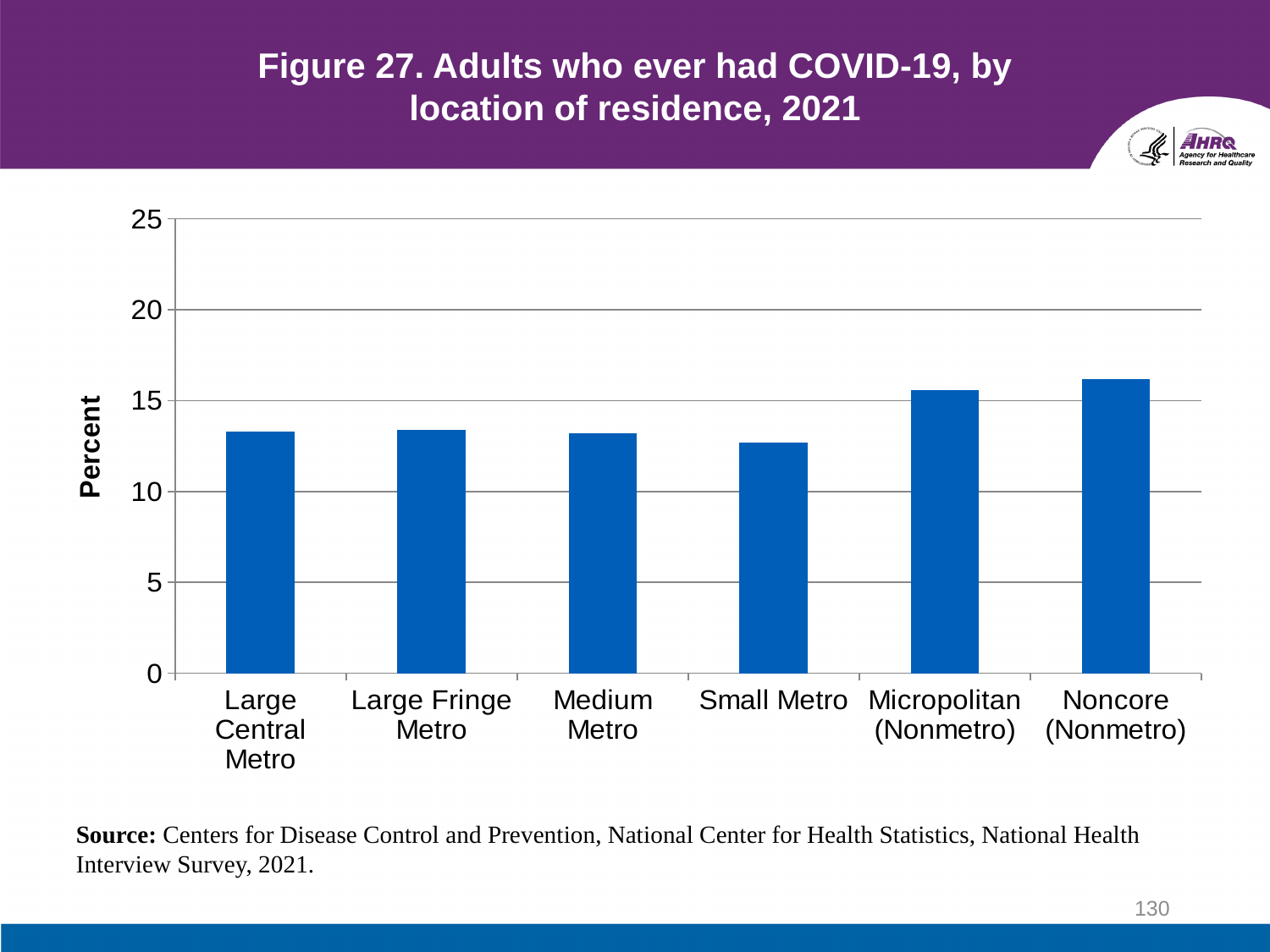
Which location of residence has the lowest percentage of adults who ever had COVID-19? Small Metro Which is larger, the value for Noncore (Nonmetro) or the value for Small Metro? Noncore (Nonmetro) Is the value for Noncore (Nonmetro) greater or less than 15? greater What is the label on the vertical axis of the chart? Percent Is the value for Micropolitan (Nonmetro) greater or less than 15? greater Which location of residence has the highest percentage of adults who ever had COVID-19? Noncore (Nonmetro) Which is larger, the value for Micropolitan (Nonmetro) or the value for Medium Metro? Micropolitan (Nonmetro) How many location-of-residence categories are shown on the x axis? 6 Is the value for Small Metro greater or less than 15? less What kind of chart is shown on the slide? Bar chart